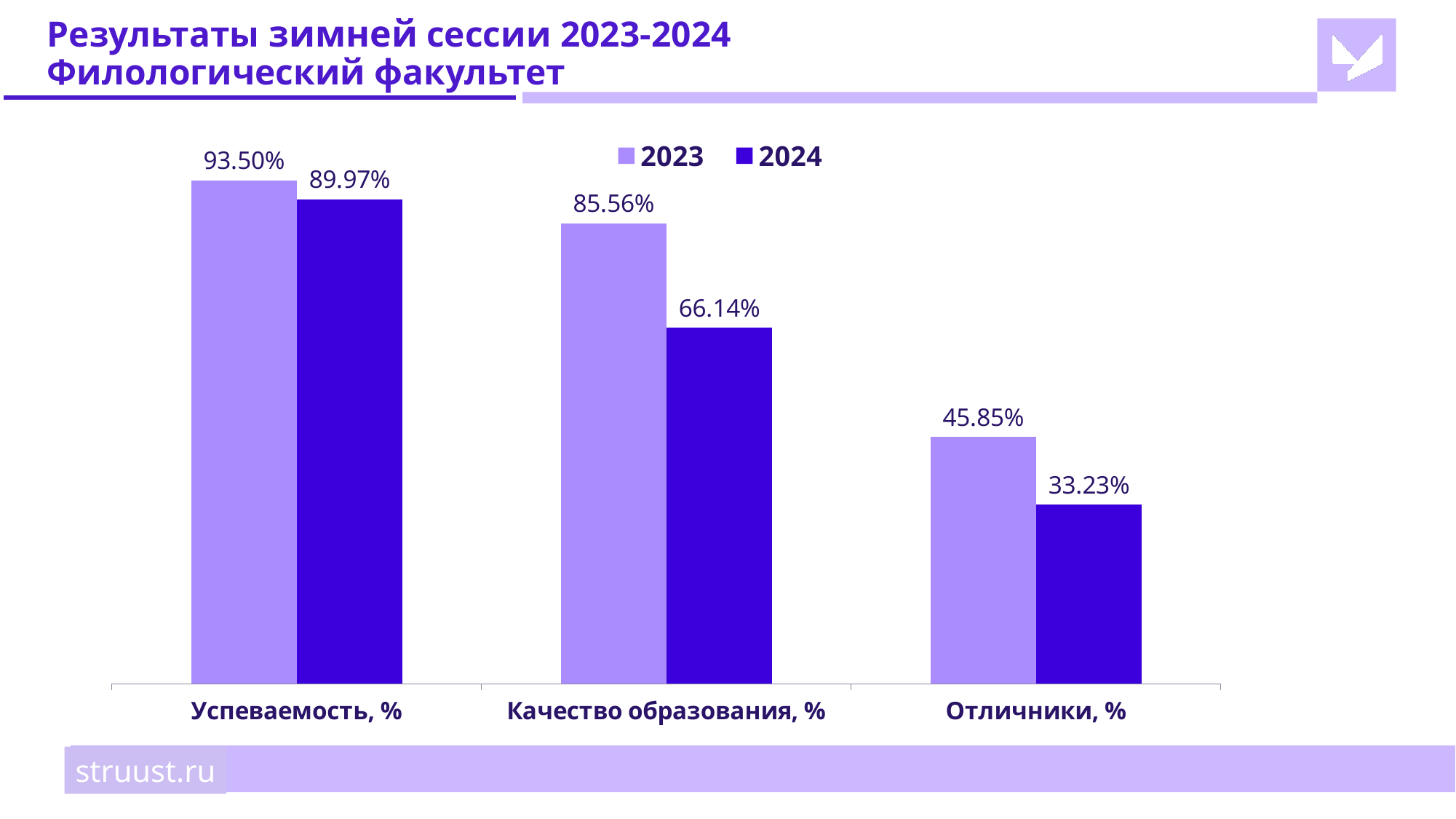
What is the 2024 value for Отличники, %? 33.23% What is the 2023 value for Успеваемость, %? 93.50% What kind of chart is shown on the slide? Bar chart What is the 2023 value for Отличники, %? 45.85% What is the difference between the 2023 and 2024 values for Успеваемость, %? 3.53% What is the 2024 value for Качество образования, %? 66.14% Which is larger for Отличники, %: the 2023 value or the 2024 value? 2023 Which category has the highest 2024 value? Успеваемость, % What is the difference between the 2023 and 2024 values for Качество образования, %? 19.42% How many categories are shown on the x axis? 3 How many series does the legend list? 2 Which category has the lowest 2023 value? Отличники, %